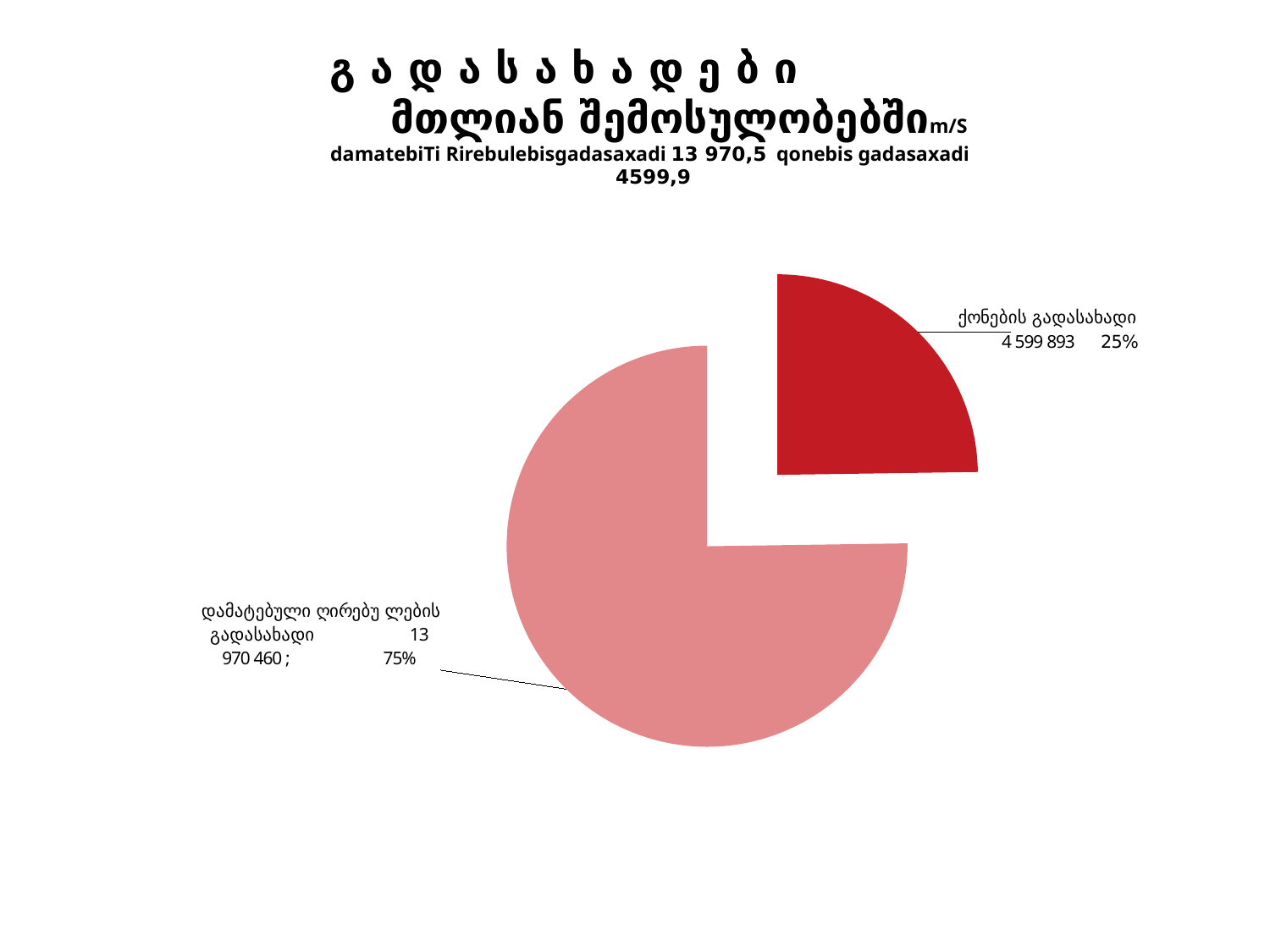
Which slice is drawn in the darker red colour? ქონების გადასახადი What value is shown for the slice labelled დამატებული ღირებულების გადასახადი? 13 970 460 What value is shown for the slice labelled ქონების გადასახადი? 4 599 893 What share of the pie does the ქონების გადასახადი slice represent? 25% What share of the pie does the დამატებული ღირებულების გადასახადი slice represent? 75% What is the difference between the values of დამატებული ღირებულების გადასახადი and ქონების გადასახადი? 9 370 567 Which slice is the largest in the pie chart? დამატებული ღირებულების გადასახადი What is the total of the two slice values in the pie chart? 18 570 353 What kind of chart is shown on the slide? pie chart Which slice is the smallest in the pie chart? ქონების გადასახადი How many slices does the pie chart have? 2 Which is larger, ქონების გადასახადი or დამატებული ღირებულების გადასახადი? დამატებული ღირებულების გადასახადი